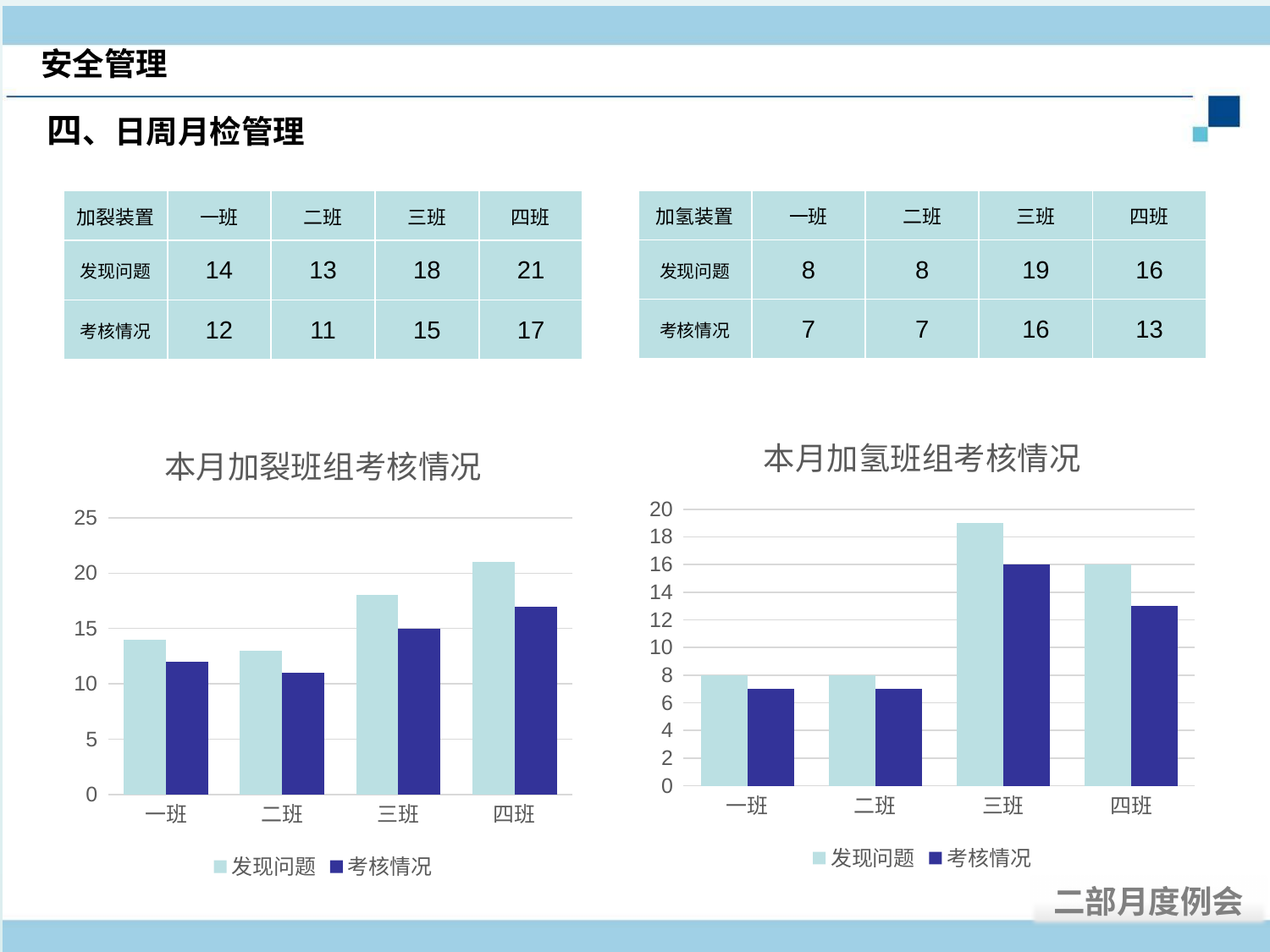
In the chart titled 本月加氢班组考核情况, what is the 发现问题 value for 一班? 8 In the chart titled 本月加裂班组考核情况, which category has the highest 发现问题 value? 四班 What are the two legend entries in the chart titled 本月加氢班组考核情况? 发现问题 and 考核情况 In the chart titled 本月加裂班组考核情况, what is the 发现问题 value for 四班? 21 In the chart titled 本月加氢班组考核情况, what is the 考核情况 value for 三班? 16 In the chart titled 本月加裂班组考核情况, what is the difference between the 发现问题 and 考核情况 values for 三班? 3 In the chart titled 本月加氢班组考核情况, is the 发现问题 value for 三班 larger than the 发现问题 value for 四班? Yes In the chart titled 本月加氢班组考核情况, which category has the lowest 考核情况 value? 一班 and 二班 (both 7) How many series does the legend of the chart titled 本月加裂班组考核情况 list? 2 How many categories are shown on the x axis of the chart titled 本月加氢班组考核情况? 4 In the chart titled 本月加裂班组考核情况, is the 考核情况 value for 二班 greater or less than 15? less What kind of chart is the chart titled 本月加氢班组考核情况? Bar chart